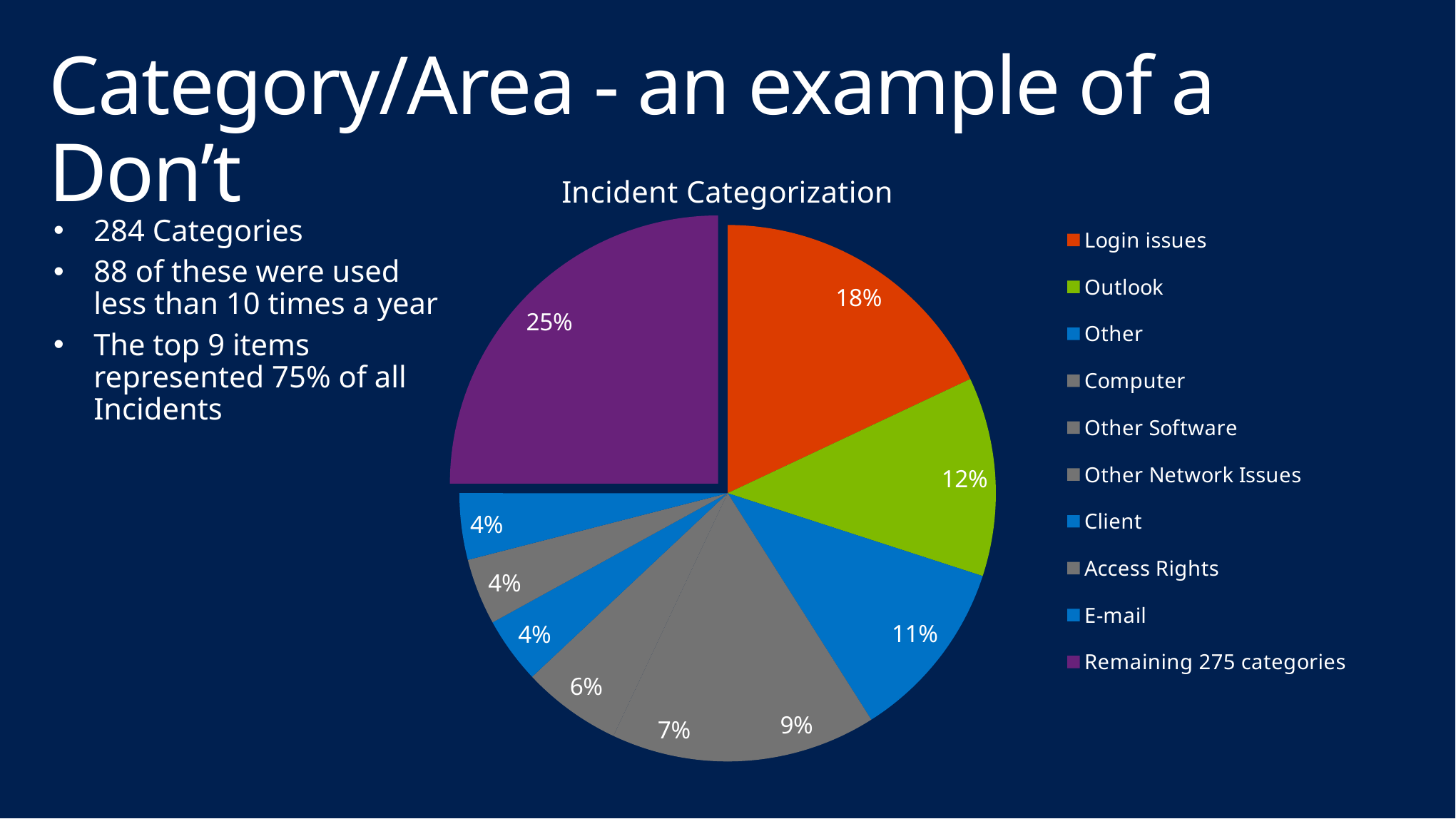
What is the difference in percentage points between Login issues and Outlook? 6% Which is larger, the Login issues slice or the Other slice? Login issues How many slices does the pie chart have? 10 What percentage is shown for the Other category? 11% What share of the pie does Outlook represent? 12% What is the title of the chart? Incident Categorization What type of chart is shown on the slide? pie chart How many entries does the legend list? 10 What percentage is shown for the Remaining 275 categories slice? 25% Which slice of the pie is the largest? Remaining 275 categories What percentage is shown for Computer? 9% What percentage of incidents is attributed to Login issues? 18%